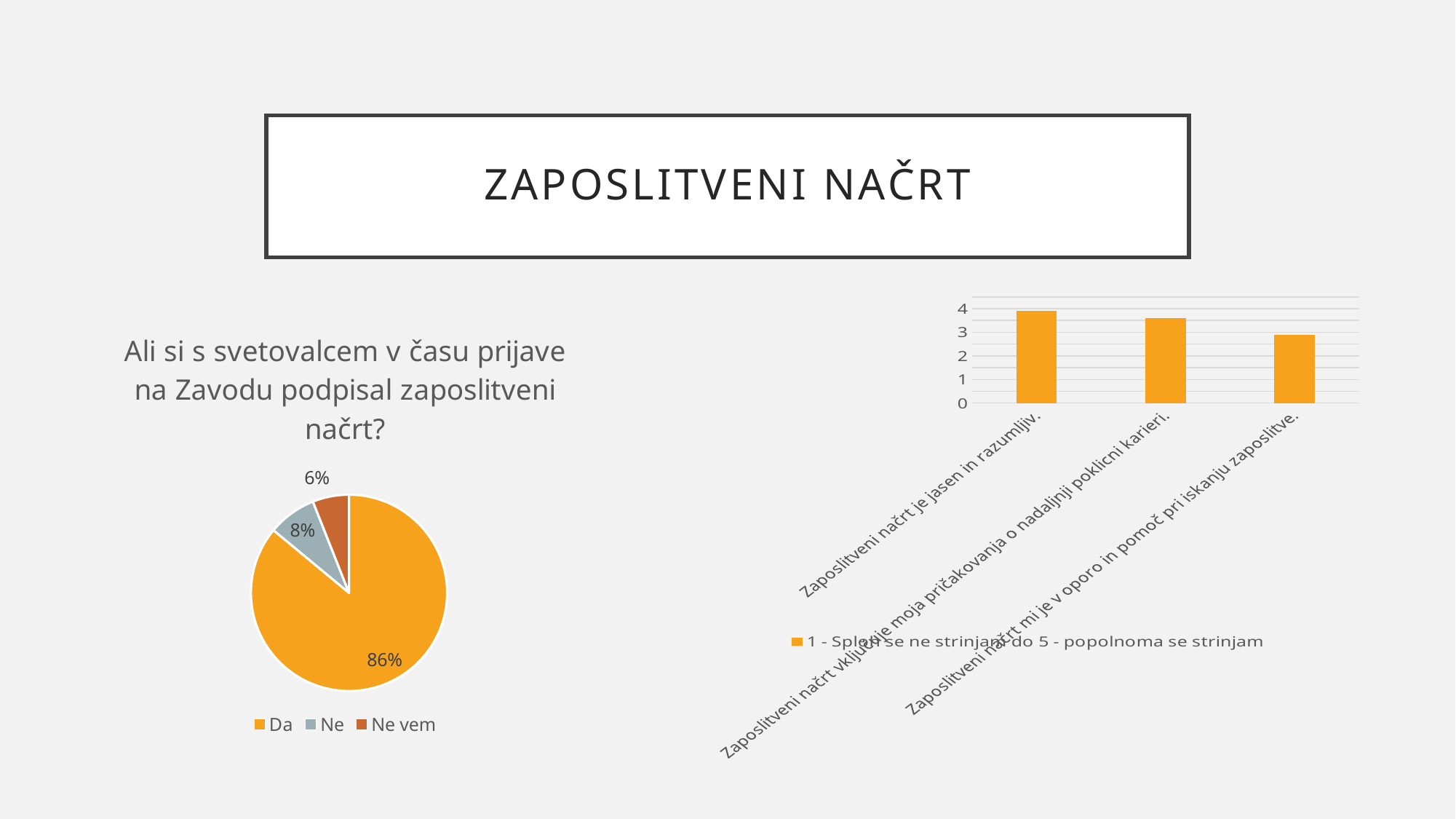
On the bar chart on the right, which is larger: the value for "Zaposlitveni načrt je jasen in razumljiv." or the value for "Zaposlitveni načrt mi je v oporo in pomoč pri iskanju zaposlitve."? Zaposlitveni načrt je jasen in razumljiv. How many series does the legend of the bar chart on the right list? 1 How many slices does the pie chart on the left have? 3 What kind of chart is on the left side of the slide? Pie chart On the pie chart on the left, what is the difference in percentage points between the "Da" and "Ne" shares? 78 percentage points On the bar chart on the right, which statement has the lowest bar? Zaposlitveni načrt mi je v oporo in pomoč pri iskanju zaposlitve. On the bar chart on the right, is the value for "Zaposlitveni načrt je jasen in razumljiv." greater or less than 3? greater On the pie chart on the left, what share of respondents answered "Ne"? 8% On the pie chart on the left, what share of respondents answered "Ne vem"? 6% What kind of chart is on the right side of the slide? Bar chart On the pie chart on the left, which answer has the smallest share? Ne vem On the pie chart on the left, what share of respondents answered "Da"? 86%